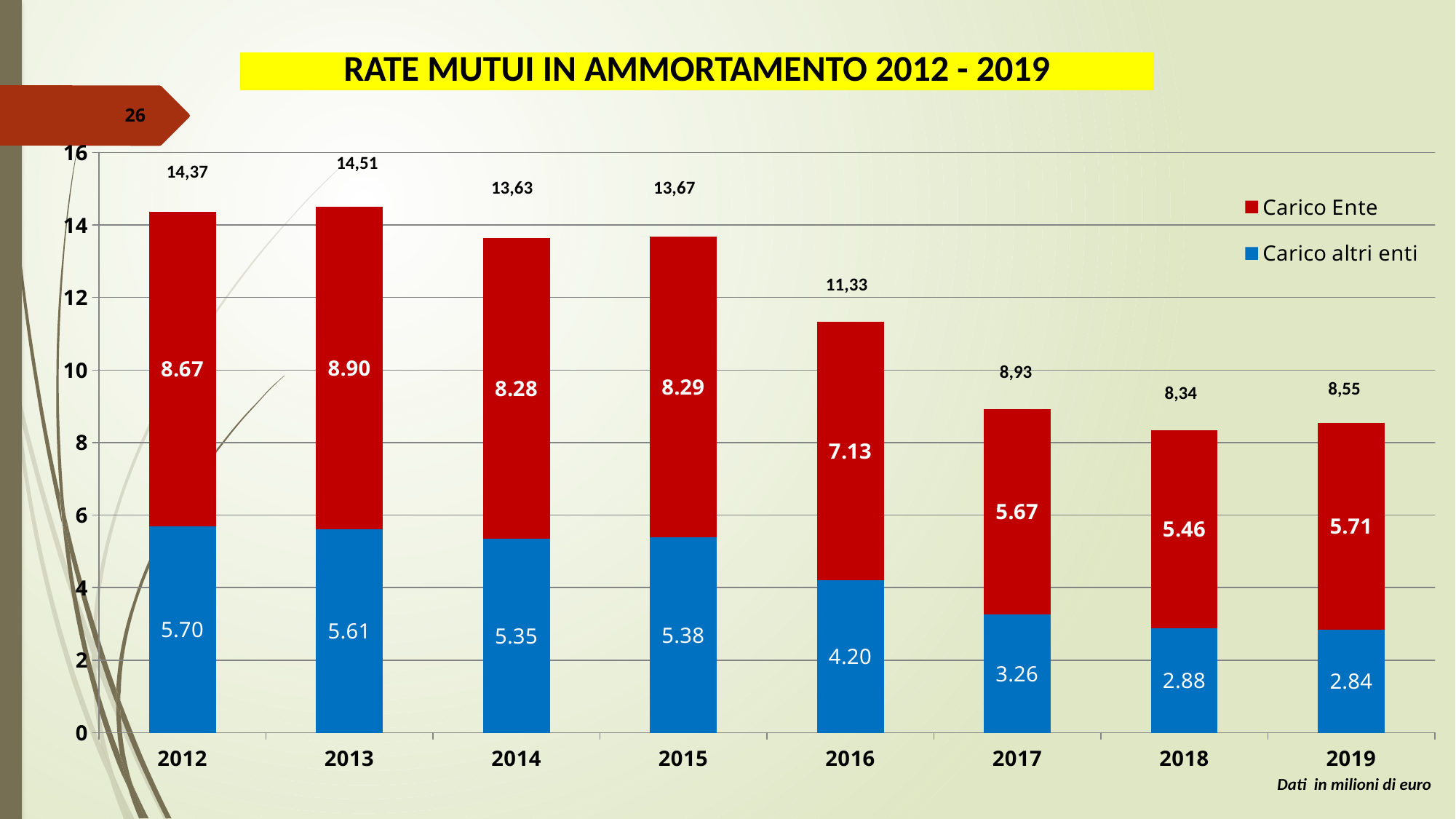
What is the Carico Ente value for 2013? 8.90 What is the Carico altri enti value for 2016? 4.20 What kind of chart is shown on the slide? stacked bar chart How many series does the legend list? 2 Is the total for 2016 greater or less than 12? less Which year has the highest total value? 2013 How many years are shown on the x axis? 8 Which year has the lowest Carico altri enti value? 2019 Which is larger, the Carico altri enti value for 2014 or for 2015? 2015 What is the total printed above the bar for 2017? 8,93 What is the title of the chart? RATE MUTUI IN AMMORTAMENTO 2012 - 2019 What is the difference between the Carico Ente values for 2012 and 2019? 2.96